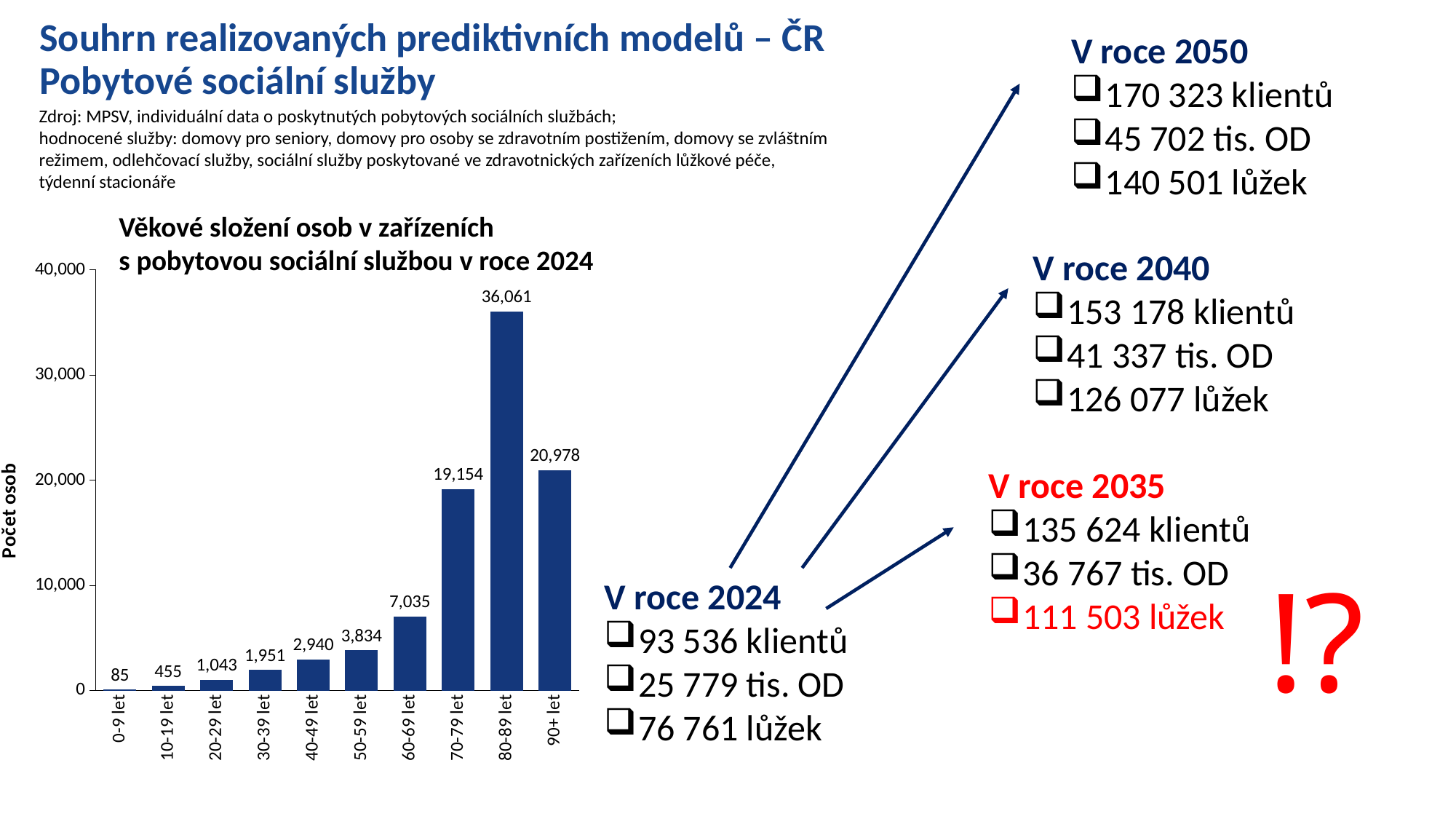
What is the label of the vertical axis? Počet osob What is the value for the 80-89 let age group? 36,061 What is the value for the 90+ let age group? 20,978 What kind of chart is shown on the slide? bar chart What is the value for the 60-69 let age group? 7,035 What is the value for the 0-9 let age group? 85 Which age group has the lowest value? 0-9 let Which is larger, the value for 90+ let or the value for 70-79 let? 90+ let Is the value for 70-79 let greater or less than 20,000? less Which age group has the highest value? 80-89 let How many age groups are shown on the x axis? 10 What is the difference between the values for 80-89 let and 70-79 let? 16,907